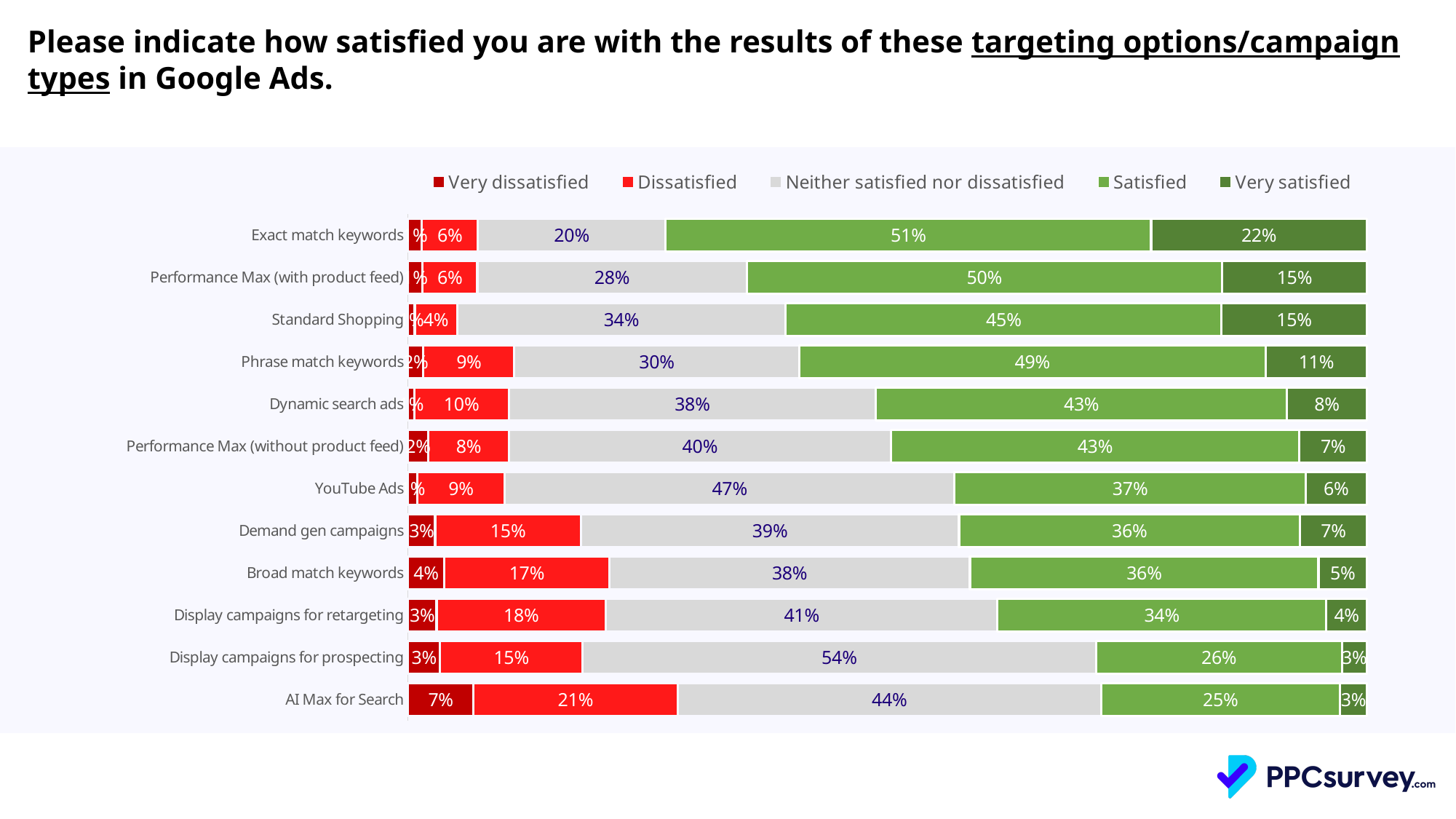
How many series does the legend list? 5 Which colour represents the Satisfied series in the chart? Light green What is the Very satisfied value for Performance Max (with product feed)? 15% What is the Neither satisfied nor dissatisfied value for Display campaigns for prospecting? 54% Which has a larger Neither satisfied nor dissatisfied value, YouTube Ads or Broad match keywords? YouTube Ads What is the Satisfied value for Exact match keywords? 51% What is the Dissatisfied value for AI Max for Search? 21% Which category has the highest Very satisfied value? Exact match keywords What kind of chart is shown on the slide? Stacked bar chart Which category has the highest Very dissatisfied value? AI Max for Search How many targeting options/campaign types are shown in the chart? 12 What is the difference between the Satisfied values for Exact match keywords and AI Max for Search? 26%